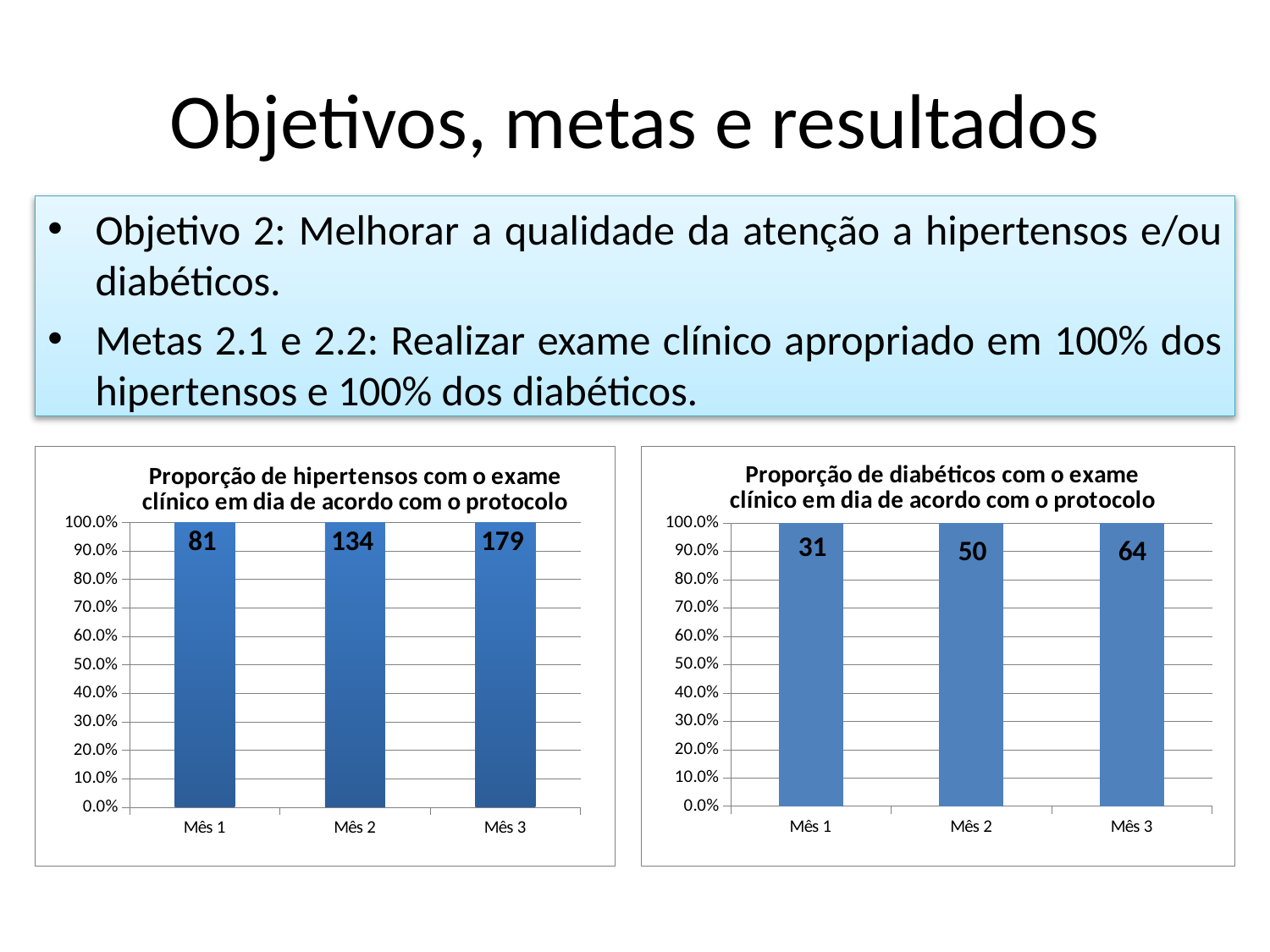
In the left chart (Proporção de hipertensos), what is the difference between the data labels for Mês 3 and Mês 1? 98 In the right chart (Proporção de diabéticos), what data label is shown on the bar for Mês 1? 31 In the right chart (Proporção de diabéticos), what is the difference between the data labels for Mês 3 and Mês 1? 33 In the left chart (Proporção de hipertensos), what data label is shown on the bar for Mês 2? 134 In the right chart (Proporção de diabéticos), which month has the smallest data label? Mês 1 In the left chart (Proporção de hipertensos), what data label is shown on the bar for Mês 3? 179 In the right chart (Proporção de diabéticos), what data label is shown on the bar for Mês 3? 64 In the right chart (Proporção de diabéticos), what percentage on the y axis does the bar for Mês 2 reach? 100.0% What kind of chart is the left chart (Proporção de hipertensos)? Bar chart In the left chart (Proporção de hipertensos), what percentage on the y axis does the bar for Mês 1 reach? 100.0% In the left chart (Proporção de hipertensos), which month has the largest data label? Mês 3 How many months are shown on the x axis of the right chart (Proporção de diabéticos)? 3